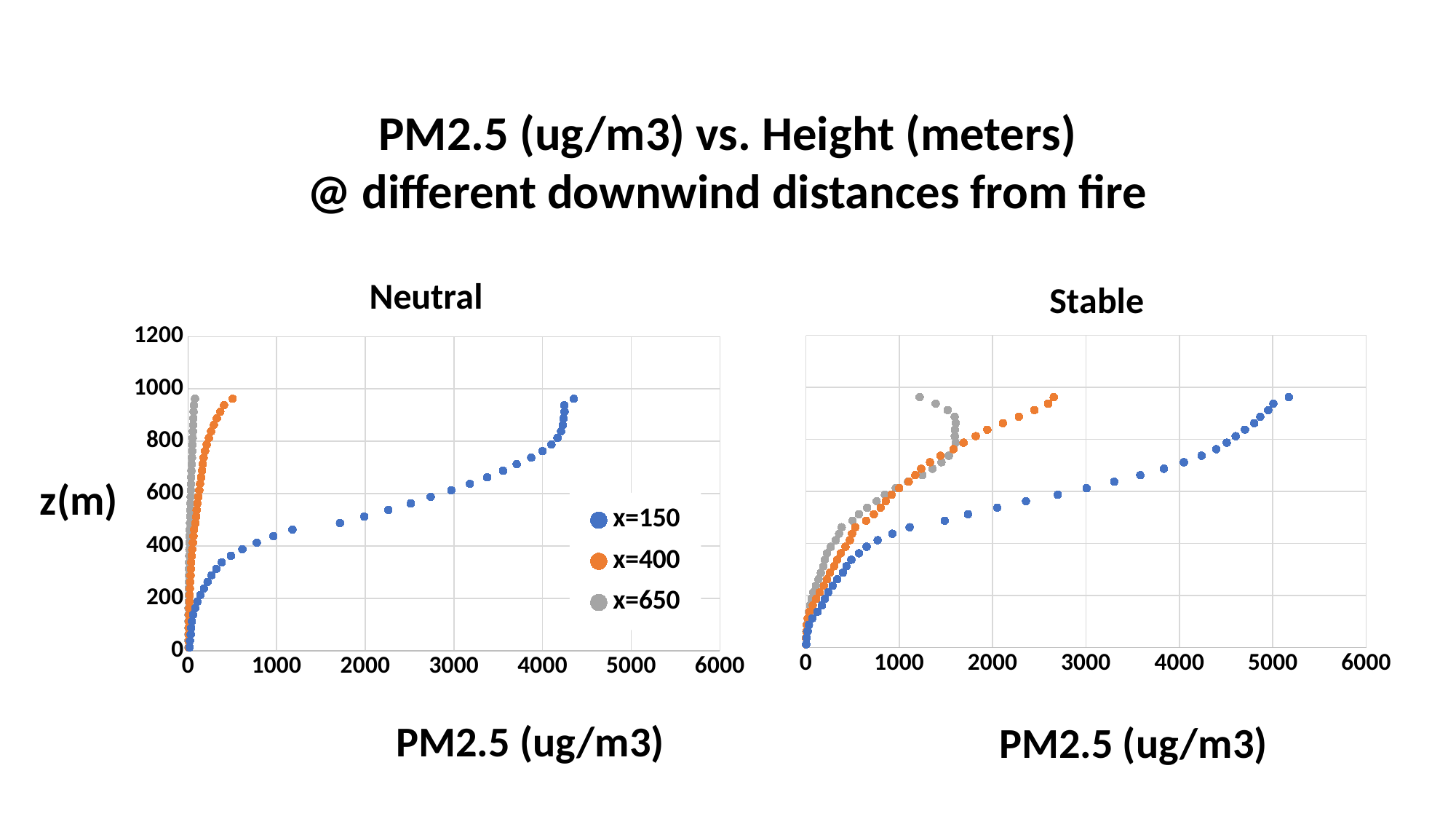
In the Neutral chart, is the highest PM2.5 value for x=400 greater or less than 1000? less In the Stable chart, which series reaches a higher PM2.5 value, x=400 or x=650? x=400 What kind of chart is the Neutral chart? scatter chart In the Stable chart, is the highest PM2.5 value for x=400 greater or less than 3000? less What are the three series names shown in the legend? x=150, x=400, x=650 What is the label on the vertical axis of the Neutral chart? z(m) In the Neutral chart, does PM2.5 for x=150 increase or decrease as height increases? increase How many series does the legend list? 3 In the Stable chart, which series reaches the lowest maximum PM2.5 value? x=650 In the Neutral chart, which series reaches the highest PM2.5 value? x=150 In the Stable chart, is the highest PM2.5 value for x=150 greater or less than 5000? greater